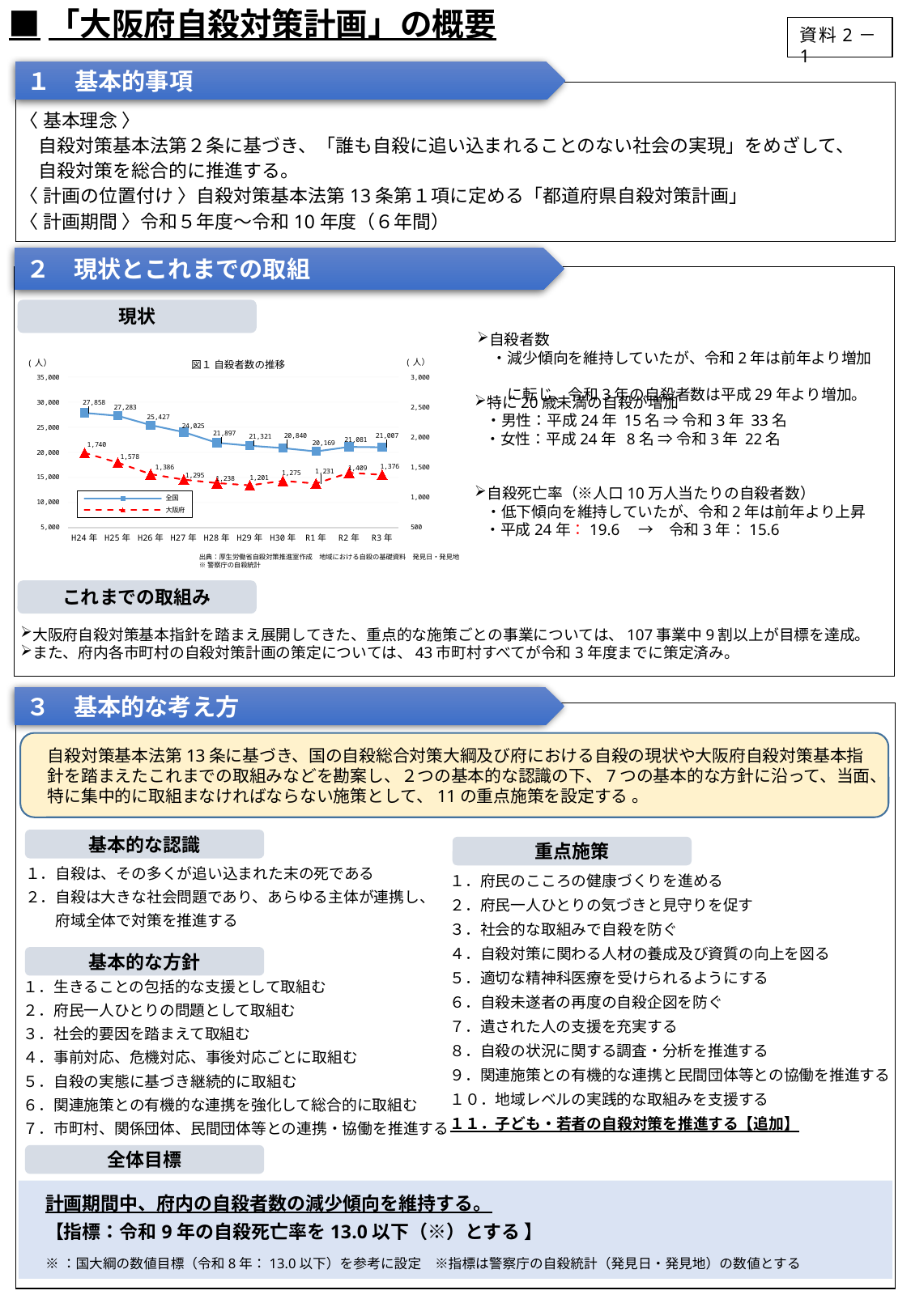
In 図1 自殺者数の推移, what is the value for 全国 in H24年? 27,858 In 図1 自殺者数の推移, is the 全国 value for R2年 larger or smaller than the value for R3年? larger In 図1 自殺者数の推移, which year has the lowest value for 大阪府? H29年 In 図1 自殺者数の推移, which year has the highest value for 全国? H24年 What is the title of the chart on the slide? 図1 自殺者数の推移 In 図1 自殺者数の推移, what is the difference between the 大阪府 values for H24年 and R3年? 364 How many series does the legend of 図1 自殺者数の推移 list? 2 In 図1 自殺者数の推移, does the 全国 series generally rise or fall from H24年 to R1年? fall What kind of chart is 図1 自殺者数の推移? line chart In 図1 自殺者数の推移, what is the value for 全国 in R1年? 20,169 How many years are plotted along the x axis of 図1 自殺者数の推移? 10 In 図1 自殺者数の推移, what is the value for 大阪府 in R3年? 1,376